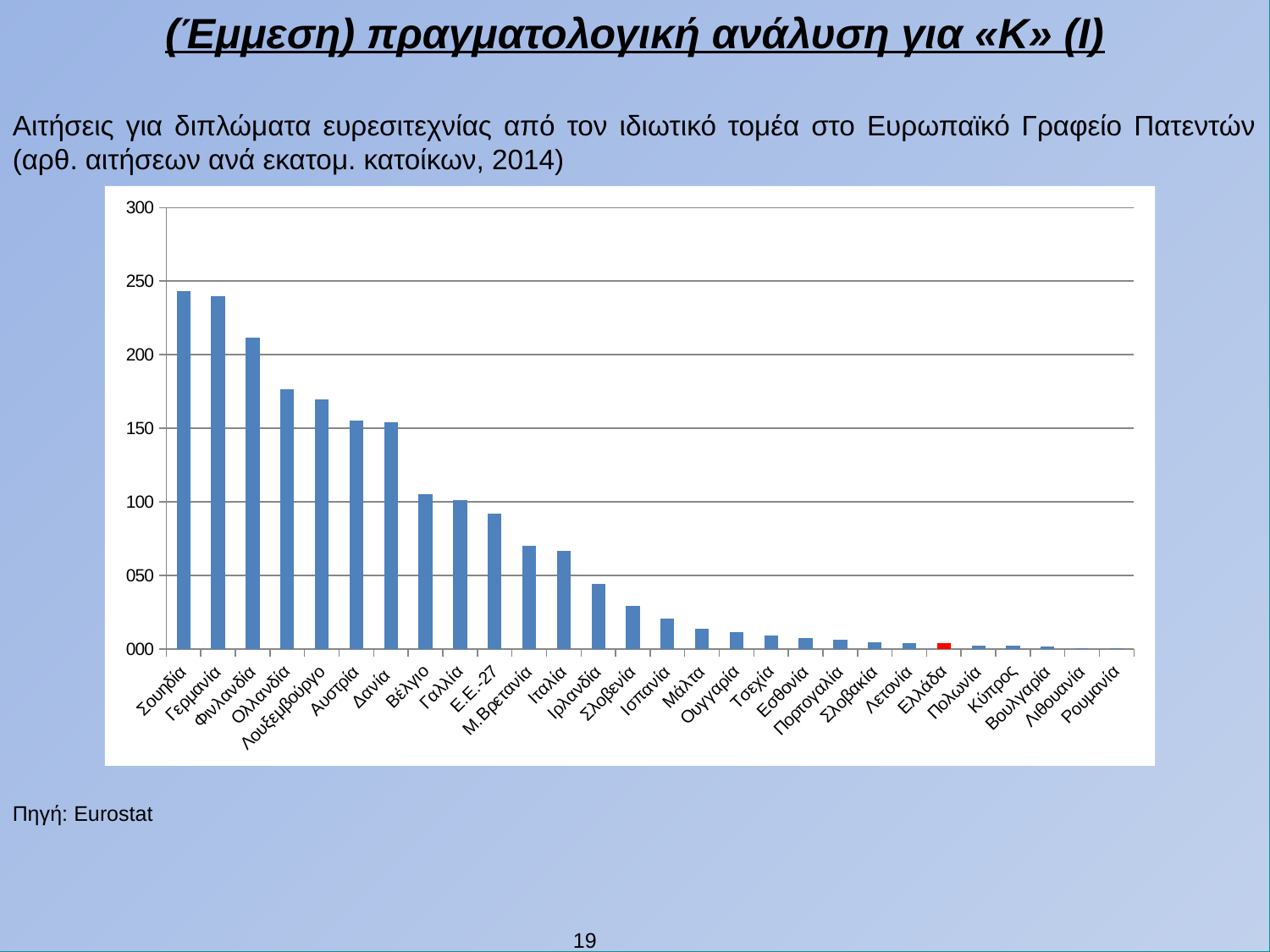
Do the values rise or fall moving from left to right along the x axis? fall Which has the larger value, Ισπανία or Ελλάδα? Ισπανία Is the value for Σουηδία greater or less than 200? greater Is the value for Ιρλανδία greater or less than 50? less What kind of chart is shown on the slide? bar chart Is the value for Ελλάδα greater or less than 50? less Which has the larger value, Φινλανδία or Ολλανδία? Φινλανδία Which country's bar is coloured red instead of blue? Ελλάδα What source is cited for the chart data? Eurostat How many countries/categories are plotted on the x axis? 28